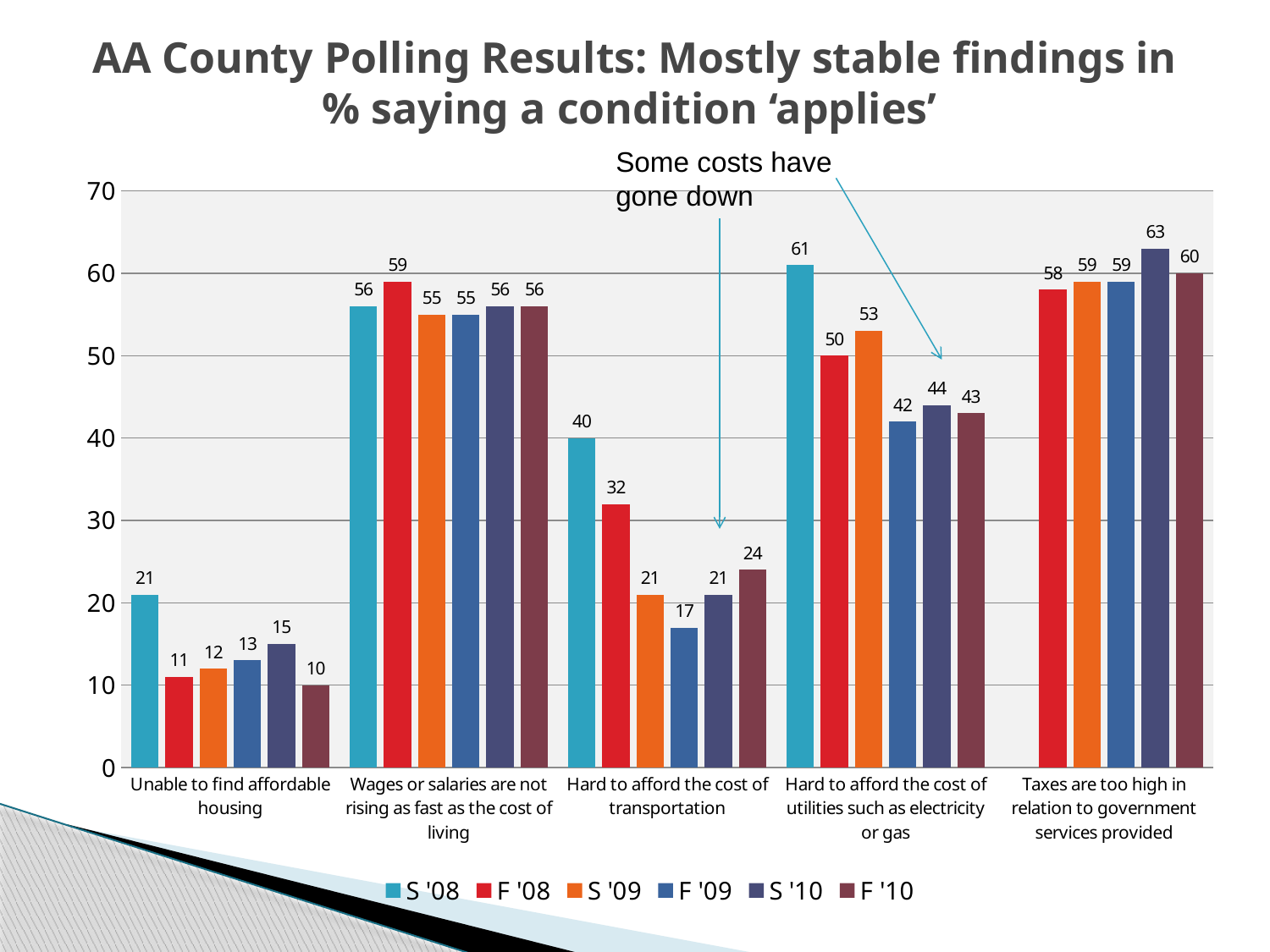
From S '08 to F '09, do the values for "Hard to afford the cost of transportation" rise or fall? Fall What is the S '08 value for "Unable to find affordable housing"? 21 What is the S '10 value for "Taxes are too high in relation to government services provided"? 63 How many condition categories are shown on the x axis? 5 Which survey wave has the highest value for "Hard to afford the cost of utilities such as electricity or gas"? S '08 What is the difference between the S '08 and F '10 values for "Hard to afford the cost of transportation"? 16 How many series does the legend list? 6 For F '08, which is larger: the value for "Wages or salaries are not rising as fast as the cost of living" or the value for "Hard to afford the cost of utilities such as electricity or gas"? Wages or salaries are not rising as fast as the cost of living What kind of chart is shown on the slide? Bar chart What does the annotation text above the chart say? Some costs have gone down What is the F '09 value for "Hard to afford the cost of transportation"? 17 Which survey wave has the lowest value for "Unable to find affordable housing"? F '10